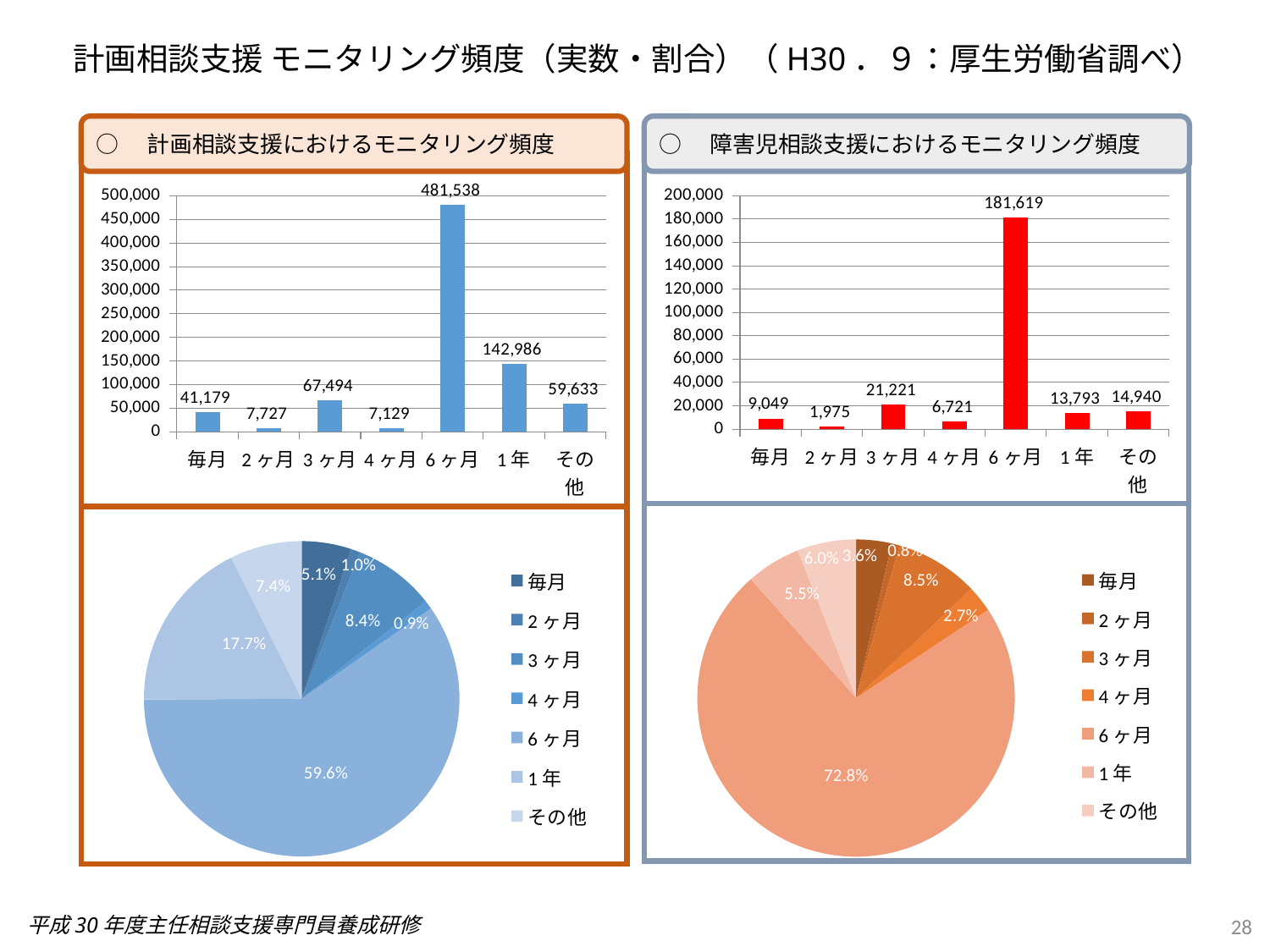
In the pie chart under 計画相談支援におけるモニタリング頻度 (bottom left), what share does 1年 have? 17.7% What kind of chart is shown at the top left of the slide under 計画相談支援におけるモニタリング頻度? Bar chart In the pie chart under 障害児相談支援におけるモニタリング頻度 (bottom right), what share does 6ヶ月 have? 72.8% In the bar chart under 計画相談支援におけるモニタリング頻度 (top left), which category has the lowest value? 4ヶ月 In the bar chart under 障害児相談支援におけるモニタリング頻度 (top right), which is larger, the value for 1年 or the value for その他? その他 In the bar chart under 計画相談支援におけるモニタリング頻度 (top left), what is the value for 1年? 142,986 How many categories are shown on the x axis of the bar chart under 障害児相談支援におけるモニタリング頻度 (top right)? 7 In the bar chart under 計画相談支援におけるモニタリング頻度 (top left), what is the value for 6ヶ月? 481,538 In the bar chart under 計画相談支援におけるモニタリング頻度 (top left), what is the difference between the values for 毎月 and 2ヶ月? 33,452 In the bar chart under 障害児相談支援におけるモニタリング頻度 (top right), which category has the highest value? 6ヶ月 In the pie chart under 計画相談支援におけるモニタリング頻度 (bottom left), what share does 6ヶ月 have? 59.6% In the bar chart under 障害児相談支援におけるモニタリング頻度 (top right), what is the value for 3ヶ月? 21,221